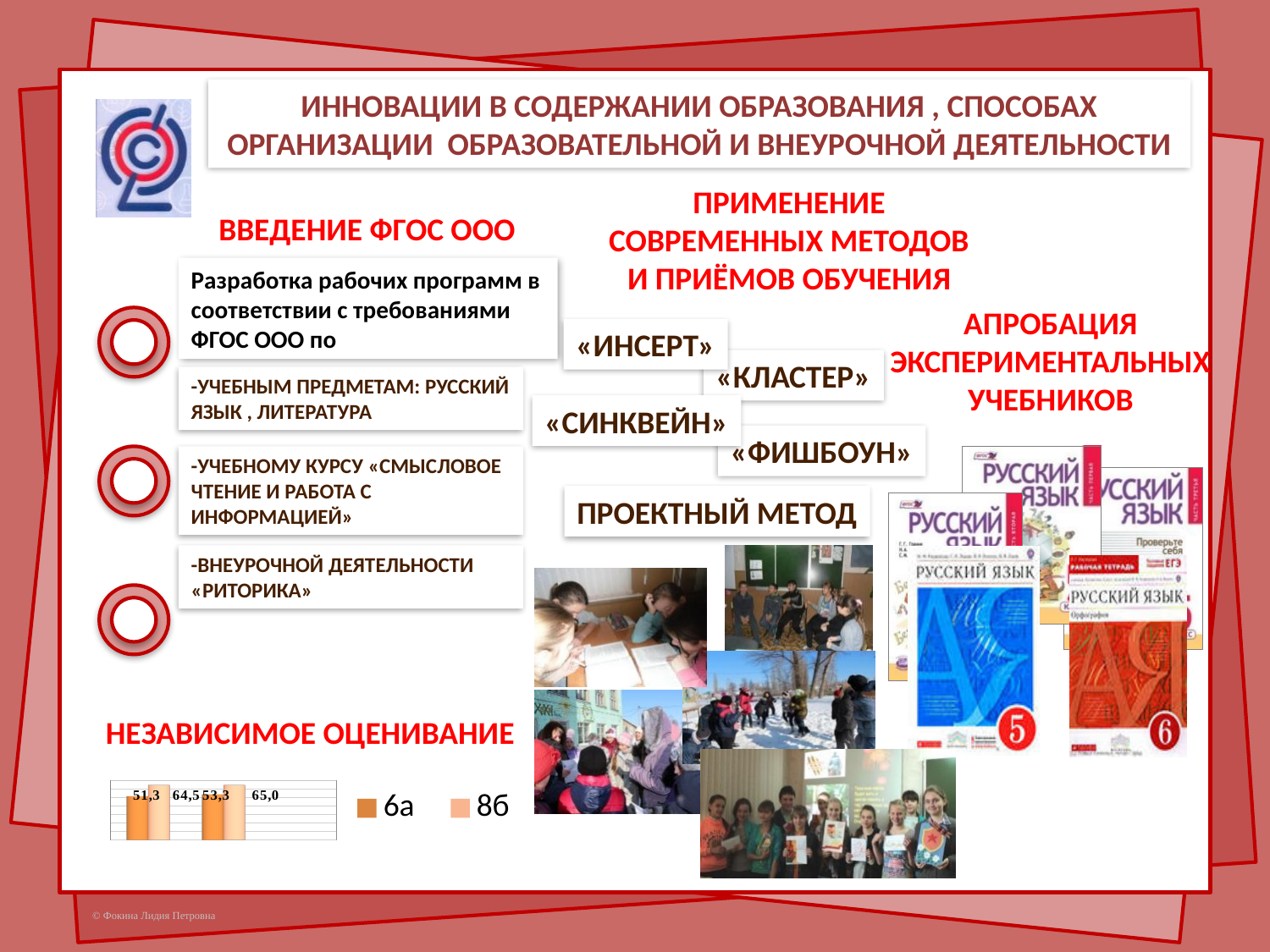
In the chart under «НЕЗАВИСИМОЕ ОЦЕНИВАНИЕ», what is the difference between the 8б and 6а bars in the first (left) group? 13,2 How many bars are plotted in the chart under «НЕЗАВИСИМОЕ ОЦЕНИВАНИЕ»? 4 What are the legend entries of the chart under «НЕЗАВИСИМОЕ ОЦЕНИВАНИЕ»? 6а and 8б In the chart under «НЕЗАВИСИМОЕ ОЦЕНИВАНИЕ», what is the value of the 6а bar in the second (right) group? 53,3 In the chart under «НЕЗАВИСИМОЕ ОЦЕНИВАНИЕ», what is the value of the 6а bar in the first (left) group? 51,3 In the chart under «НЕЗАВИСИМОЕ ОЦЕНИВАНИЕ», which series has the larger value in the second (right) group, 6а or 8б? 8б What is the highest value labelled in the chart under «НЕЗАВИСИМОЕ ОЦЕНИВАНИЕ»? 65,0 In the chart under «НЕЗАВИСИМОЕ ОЦЕНИВАНИЕ», what is the difference between the highest and lowest labelled values? 13,7 What is the lowest value labelled in the chart under «НЕЗАВИСИМОЕ ОЦЕНИВАНИЕ»? 51,3 How many series does the legend of the chart under «НЕЗАВИСИМОЕ ОЦЕНИВАНИЕ» list? 2 What kind of chart is shown under the heading «НЕЗАВИСИМОЕ ОЦЕНИВАНИЕ»? bar chart In the chart under «НЕЗАВИСИМОЕ ОЦЕНИВАНИЕ», what is the value of the 8б bar in the first (left) group? 64,5